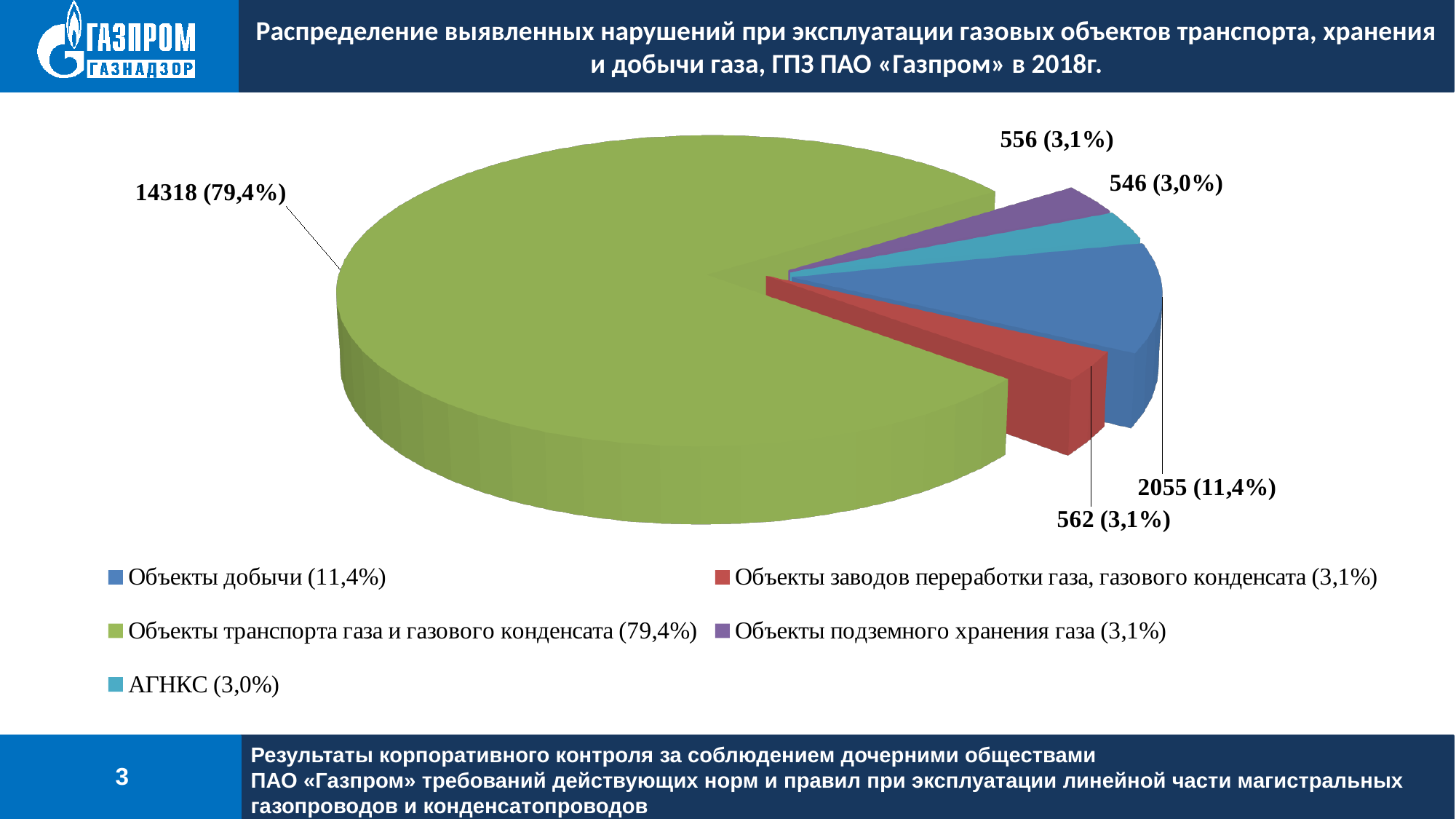
What share of the pie does Объекты добычи represent? 11,4% What share of the pie does Объекты подземного хранения газа represent? 3,1% Which category has the largest slice? Объекты транспорта газа и газового конденсата Which category has the smallest value? АГНКС What is the value for Объекты транспорта газа и газового конденсата? 14318 What is the value for Объекты заводов переработки газа, газового конденсата? 562 Which colour represents Объекты подземного хранения газа in the pie chart? Purple What is the difference between the values for Объекты добычи and Объекты заводов переработки газа, газового конденсата? 1493 What is the value for Объекты добычи? 2055 What kind of chart is shown on the slide? Pie chart What is the value for АГНКС? 546 How many slices does the pie chart have? 5